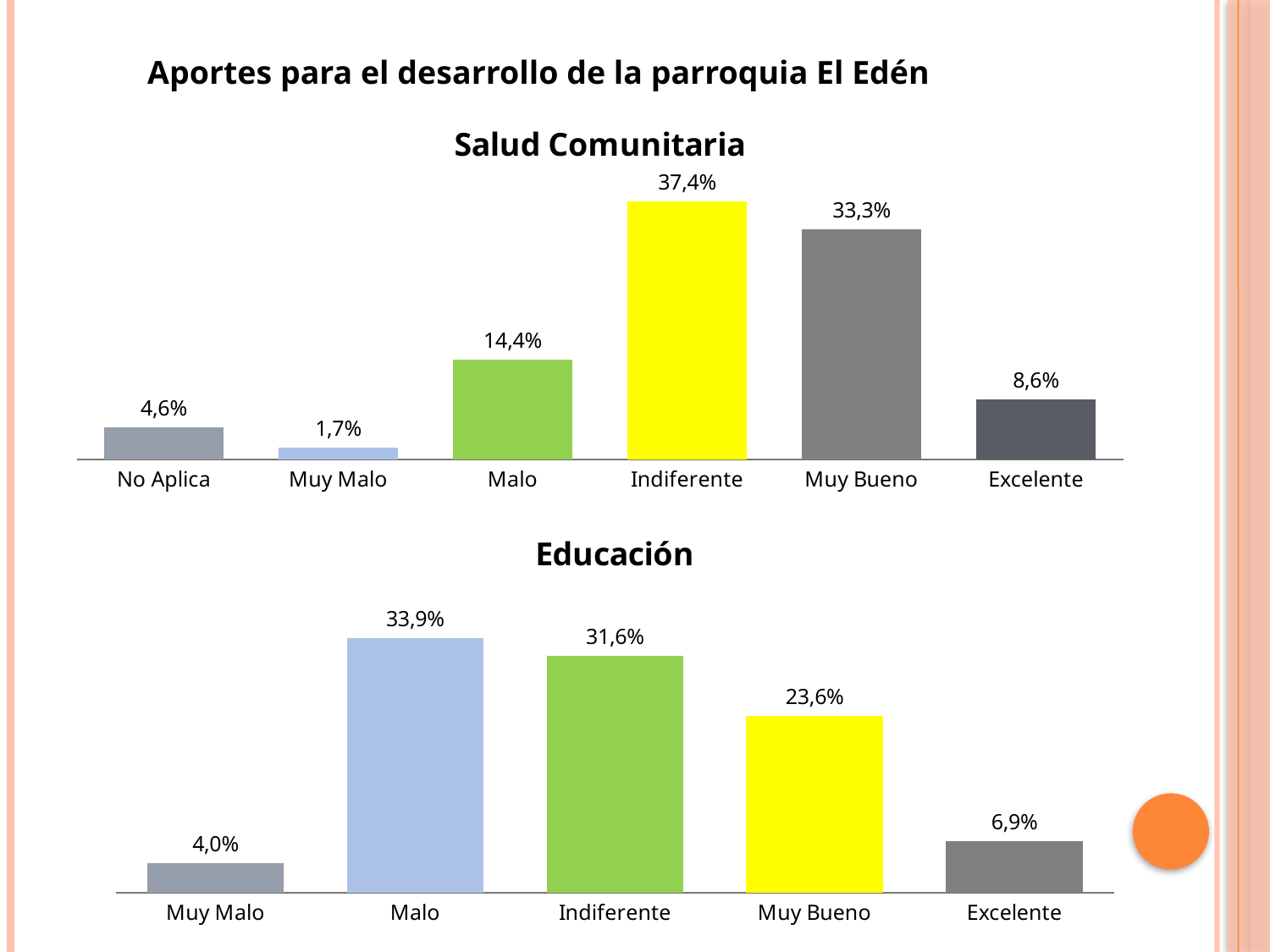
What is the title of the top chart on the slide? Salud Comunitaria In the Educación chart, which is larger, Indiferente or Muy Bueno? Indiferente What kind of chart is the Educación chart? Bar chart In the Salud Comunitaria chart, which category has the lowest value? Muy Malo In the Educación chart, how many categories are shown? 5 In the Salud Comunitaria chart, what is the difference between Indiferente and Muy Bueno? 4,1% In the Salud Comunitaria chart, what is the value for Excelente? 8,6% In the Educación chart, what is the value for Muy Bueno? 23,6% In the Educación chart, what is the difference between Malo and Excelente? 27,0% In the Salud Comunitaria chart, what is the value for Indiferente? 37,4% In the Educación chart, which category has the highest value? Malo In the Salud Comunitaria chart, how many categories are shown? 6